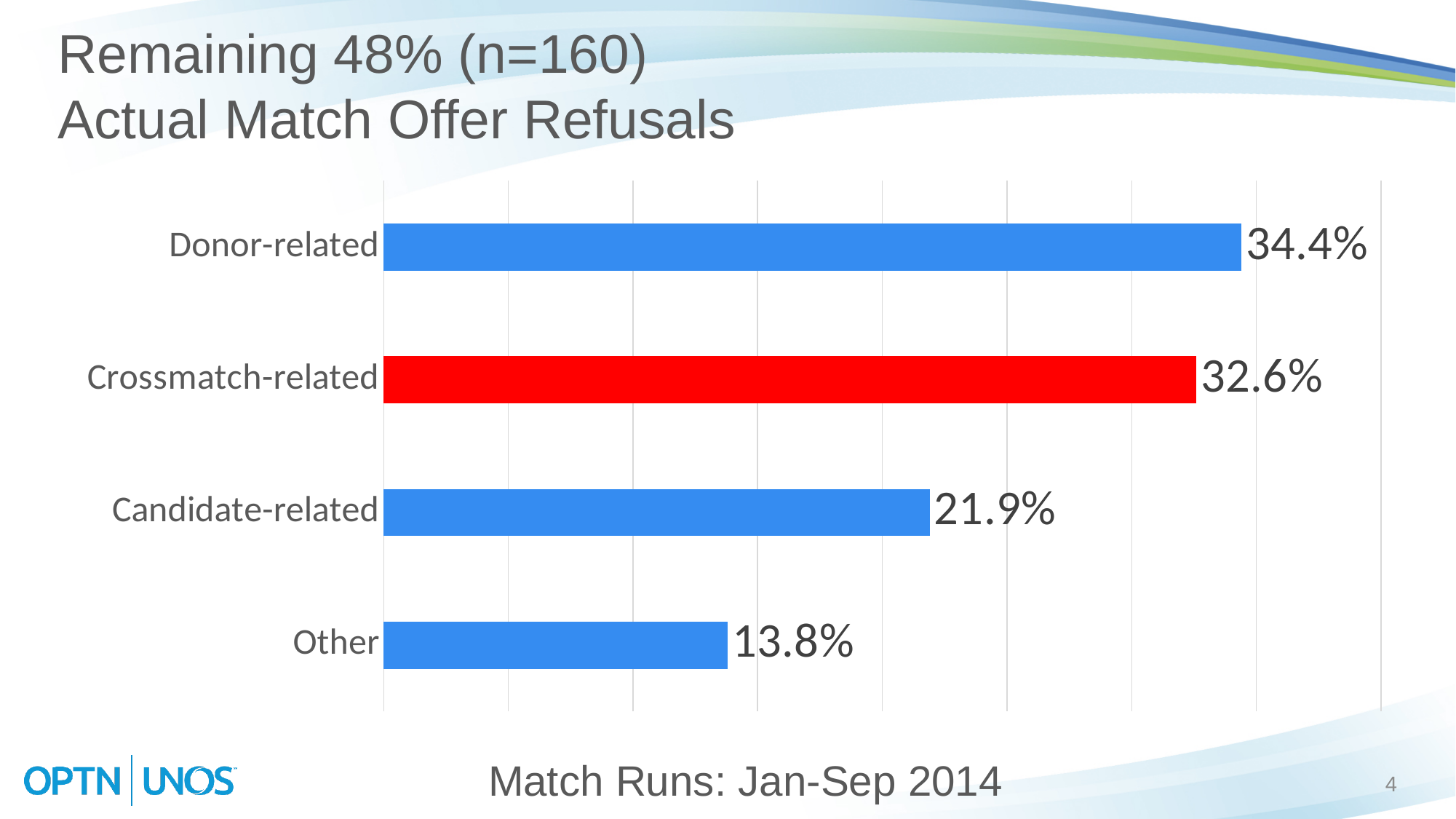
What kind of chart is shown on the slide? Bar chart How many categories are shown in the chart? 4 What is the value for Donor-related? 34.4% What is the value for Candidate-related? 21.9% What is the difference between the values for Donor-related and Crossmatch-related? 1.8% Which category's bar is coloured red? Crossmatch-related What is the difference between the values for Candidate-related and Other? 8.1% What is the value for Crossmatch-related? 32.6% Which is larger, the value for Candidate-related or the value for Other? Candidate-related What is the value for Other? 13.8% Which category has the highest value? Donor-related Which category has the lowest value? Other